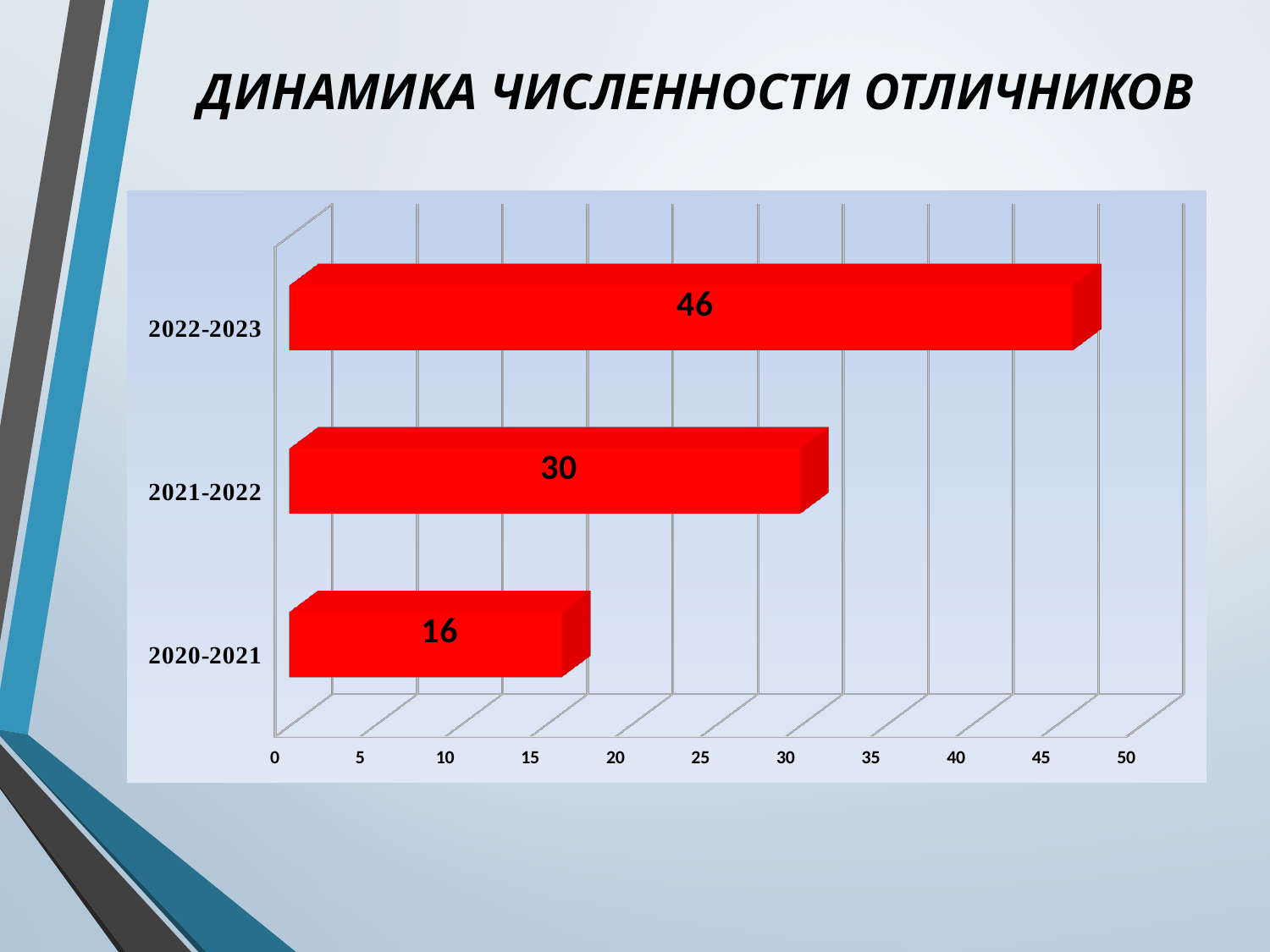
What kind of chart is shown on the slide? bar chart What is the value for 2022-2023? 46 What is the value for 2020-2021? 16 What is the difference between the values for 2021-2022 and 2020-2021? 14 What is the value for 2021-2022? 30 What is the difference between the values for 2022-2023 and 2021-2022? 16 How many academic years are shown in the chart? 3 Which academic year has the lowest value? 2020-2021 Is the value for 2022-2023 greater or less than 40? greater Which is larger, the value for 2021-2022 or the value for 2020-2021? 2021-2022 Which academic year has the highest value? 2022-2023 What is the title of the chart? ДИНАМИКА ЧИСЛЕННОСТИ ОТЛИЧНИКОВ